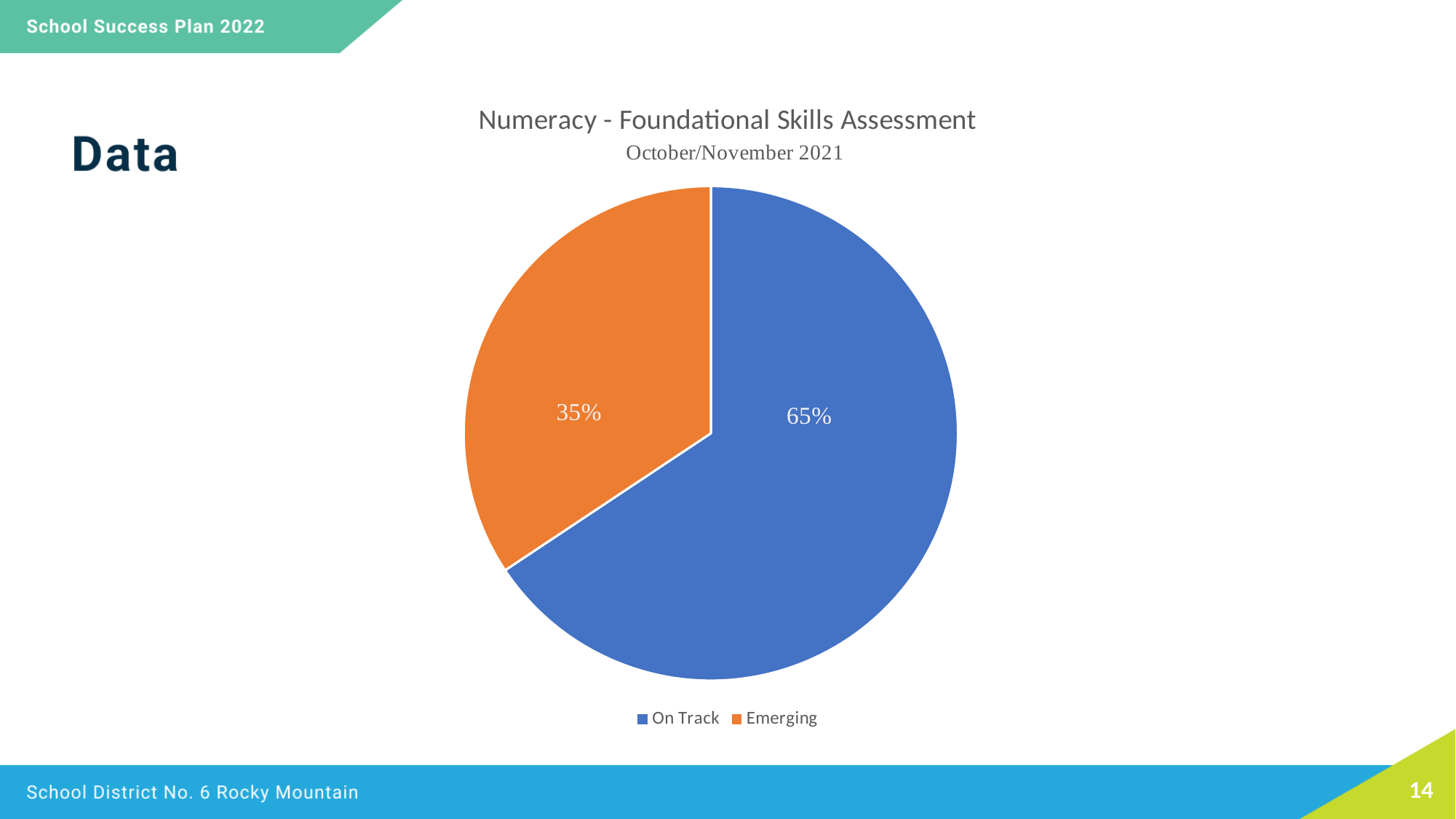
What is the title of the chart? Numeracy - Foundational Skills Assessment Which is larger, the On Track slice or the Emerging slice? On Track What share of the pie does the On Track slice represent? 65% What percentage of the pie is labelled On Track? 65% What kind of chart is shown on the slide? pie chart What colour is the Emerging slice? orange Which category has the smallest share of the pie? Emerging Which category has the largest share of the pie? On Track How many slices does the pie chart have? 2 What is the difference in percentage points between the On Track and Emerging slices? 30 How many entries does the legend list? 2 What percentage of the pie is labelled Emerging? 35%